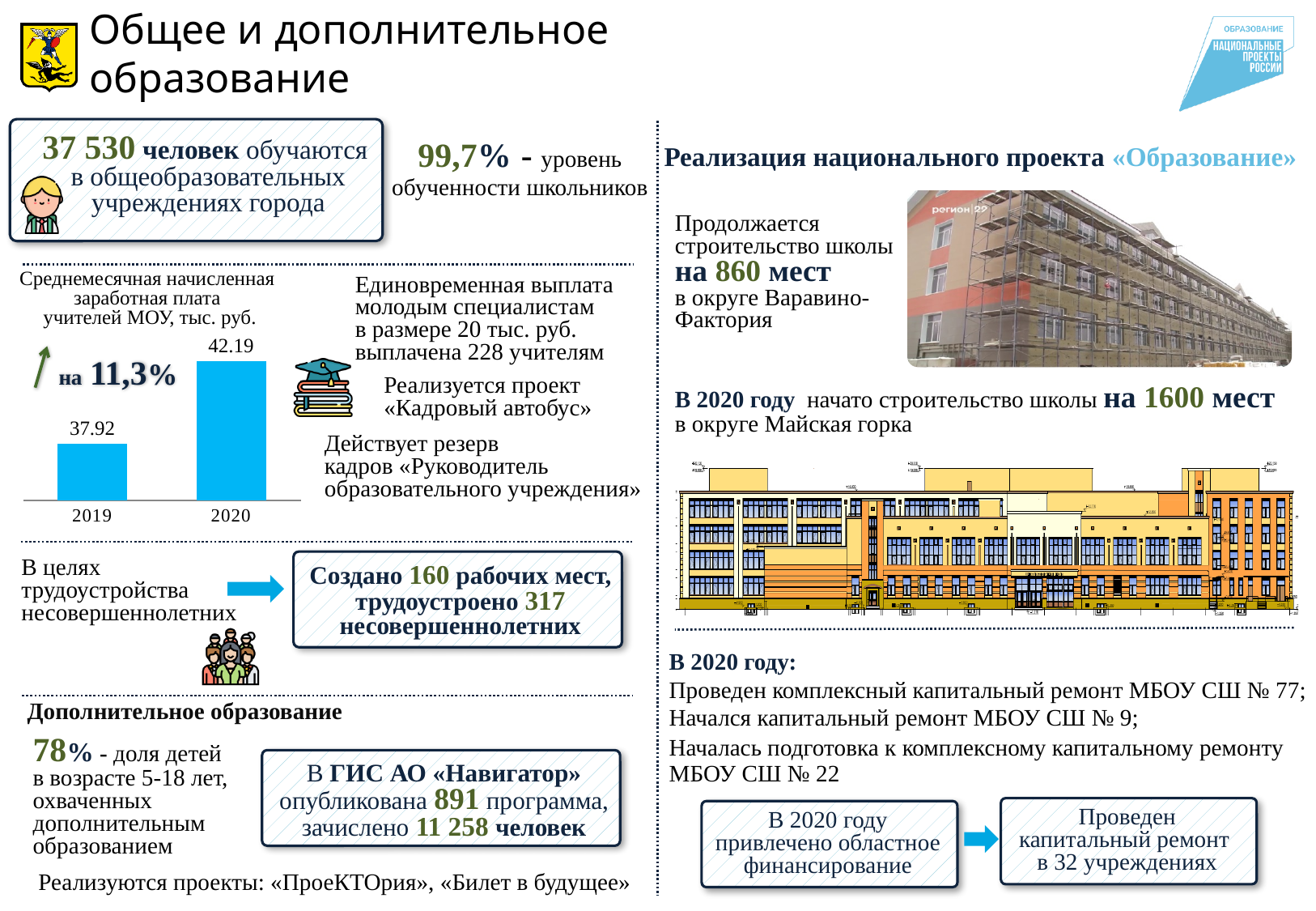
By how much does the 2020 value exceed the 2019 value in the teachers' salary chart? 4.27 How many bars (years) are shown in the teachers' salary chart? 2 Which year has the lower value in the teachers' salary chart? 2019 What percentage growth is indicated next to the teachers' salary chart? на 11,3% What type of chart is used to show the average monthly salary of teachers? bar chart In the teachers' salary chart, is the value for 2020 larger or smaller than the value for 2019? larger What is the value for 2019 in the chart of average monthly accrued salary of teachers (Среднемесячная начисленная заработная плата учителей МОУ)? 37.92 What is the value for 2020 in the teachers' salary chart? 42.19 In what units are the values of the teachers' salary chart given, according to its title? тыс. руб. Does the teachers' salary value rise or fall from 2019 to 2020? rise Which year has the higher value in the teachers' salary chart? 2020